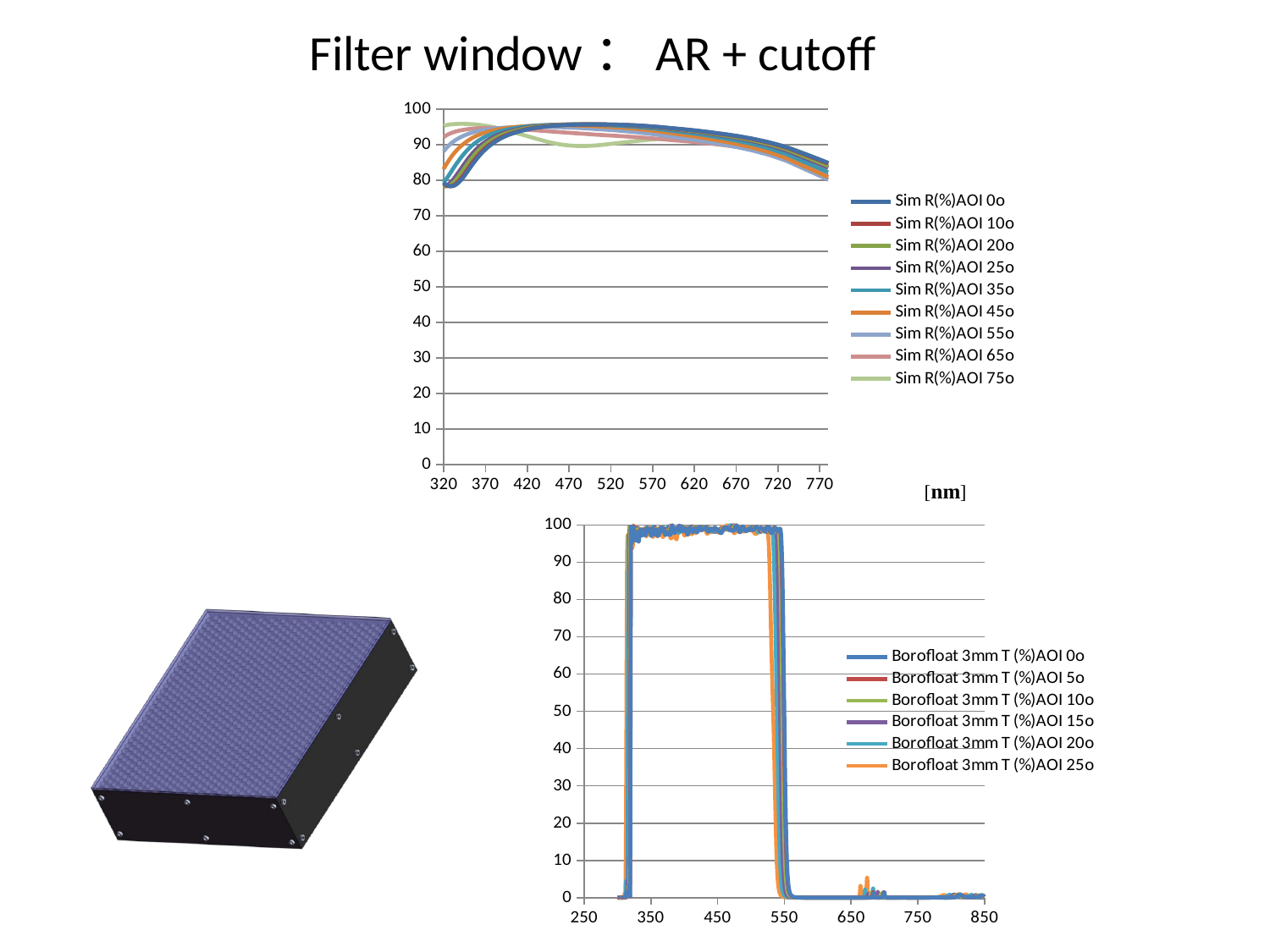
In the top chart, do the values rise or fall along the x axis between 620 and 770 nm? fall In the top chart, is the value of Sim R(%)AOI 0o at 770 nm greater or less than 70? greater What kind of chart is the top chart on the slide? line chart In the bottom chart, is the value of Borofloat 3mm T (%)AOI 0o at 750 greater or less than 10? less How many series does the legend of the top chart list? 9 In the bottom chart, do the values rise or fall along the x axis between 550 and 650? fall What unit is shown for the x axis of the top chart? [nm] What is the last legend entry of the top chart? Sim R(%)AOI 75o How many series does the legend of the bottom chart list? 6 In the top chart, is the value of Sim R(%)AOI 0o at 470 nm greater or less than 90? greater What kind of chart is the bottom chart on the slide? line chart